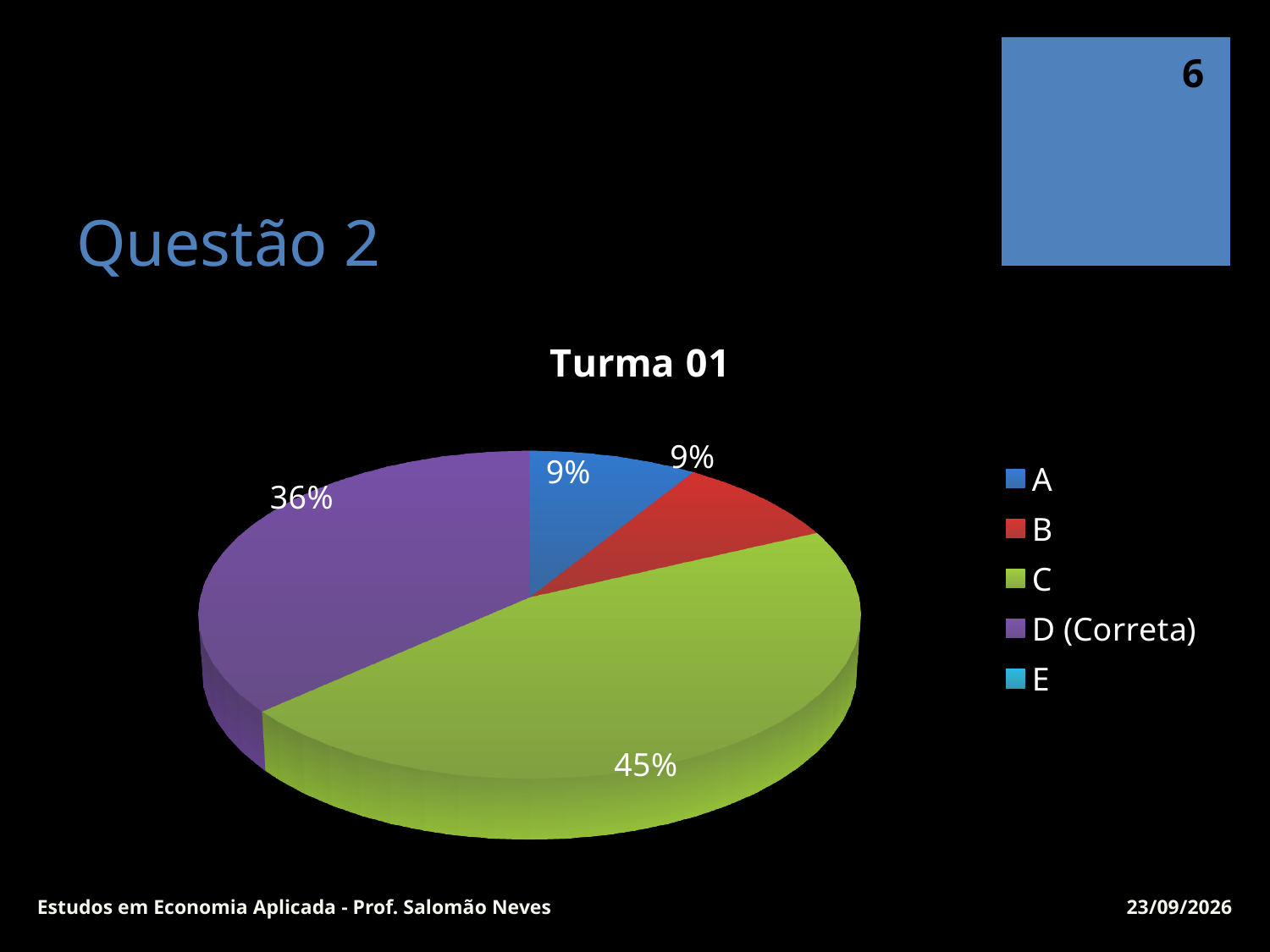
Which legend entry is marked as the correct answer? D (Correta) What kind of chart is shown on the slide? pie chart What is the combined share of the A and B slices? 18% Which category has the largest slice of the pie? C What is the difference in percentage points between the C slice and the D (Correta) slice? 9 What share of the pie does D (Correta) represent? 36% What share of the pie does A represent? 9% How many entries does the legend list? 5 What share of the pie does C represent? 45% What is the title of the chart? Turma 01 What share of the pie does B represent? 9% Which slice is larger, C or D (Correta)? C